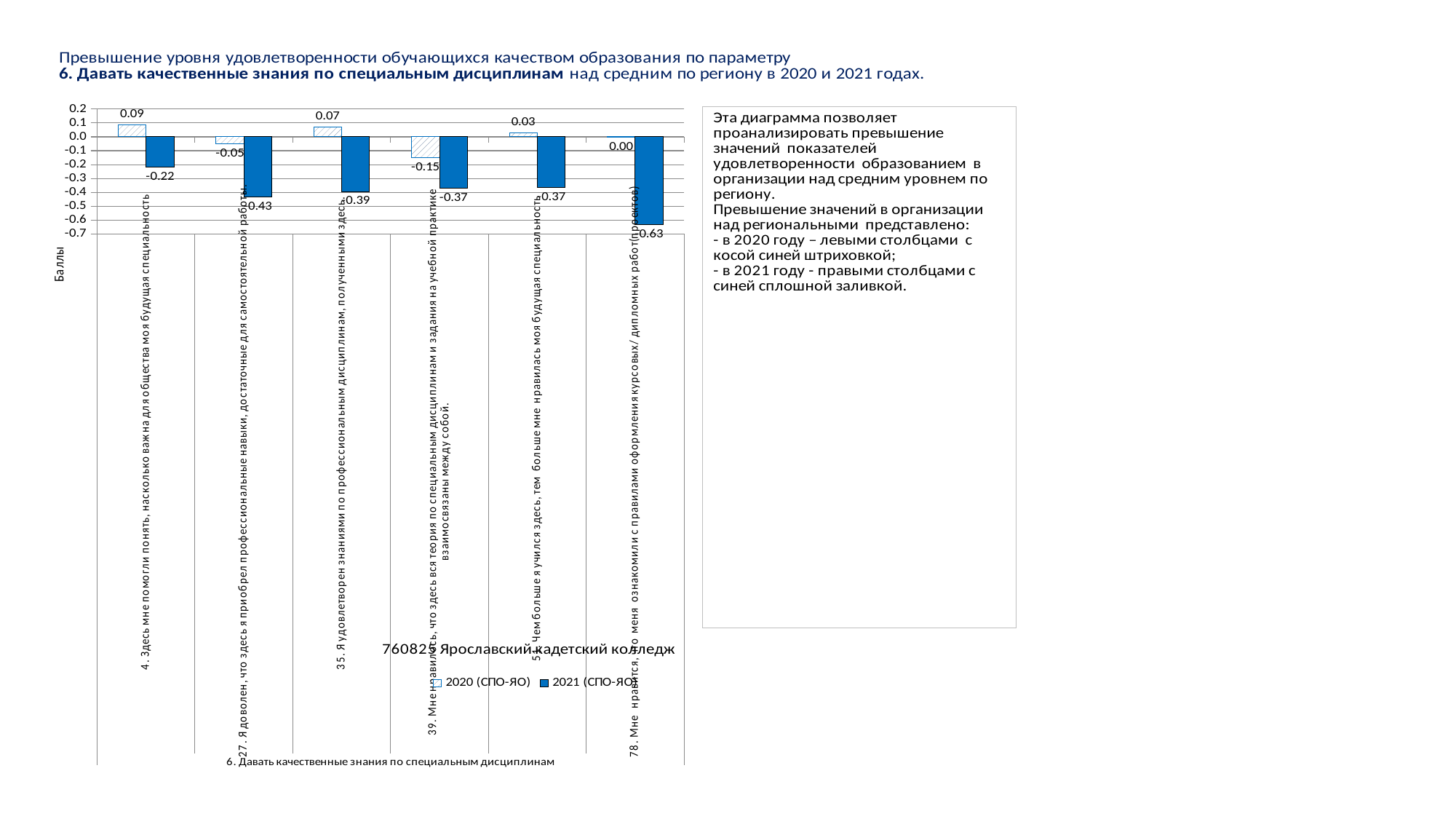
Which category has the highest 2020 (СПО-ЯО) value? 4. Здесь мне помогли понять, насколько важна для общества моя будущая специальность What is the difference between the 2020 and 2021 values for item 35 ("Я удовлетворен знаниями по профессиональным дисциплинам, полученными здесь")? 0.46 What is the 2020 (СПО-ЯО) value for item 4 ("Здесь мне помогли понять, насколько важна для общества моя будущая специальность")? 0.09 What is the 2021 (СПО-ЯО) value for item 27 ("Я доволен, что здесь я приобрел профессиональные навыки...")? -0.43 How many categories are shown on the x axis of the chart? 6 What is the 2021 (СПО-ЯО) value for item 78 ("Мне нравится, что меня ознакомили с правилами оформления курсовых/дипломных работ")? -0.63 How many series does the chart legend list? 2 What type of chart is shown on the slide? Bar chart Which is larger for item 4: the 2020 (СПО-ЯО) value or the 2021 (СПО-ЯО) value? 2020 (СПО-ЯО) Which category has the lowest 2021 (СПО-ЯО) value? 78. Мне нравится, что меня ознакомили с правилами оформления курсовых/дипломных работ What is the 2020 (СПО-ЯО) value for item 39 ("Мне нравилось, что здесь вся теория по специальным дисциплинам и задания на учебной практике взаимосвязаны между собой")? -0.15